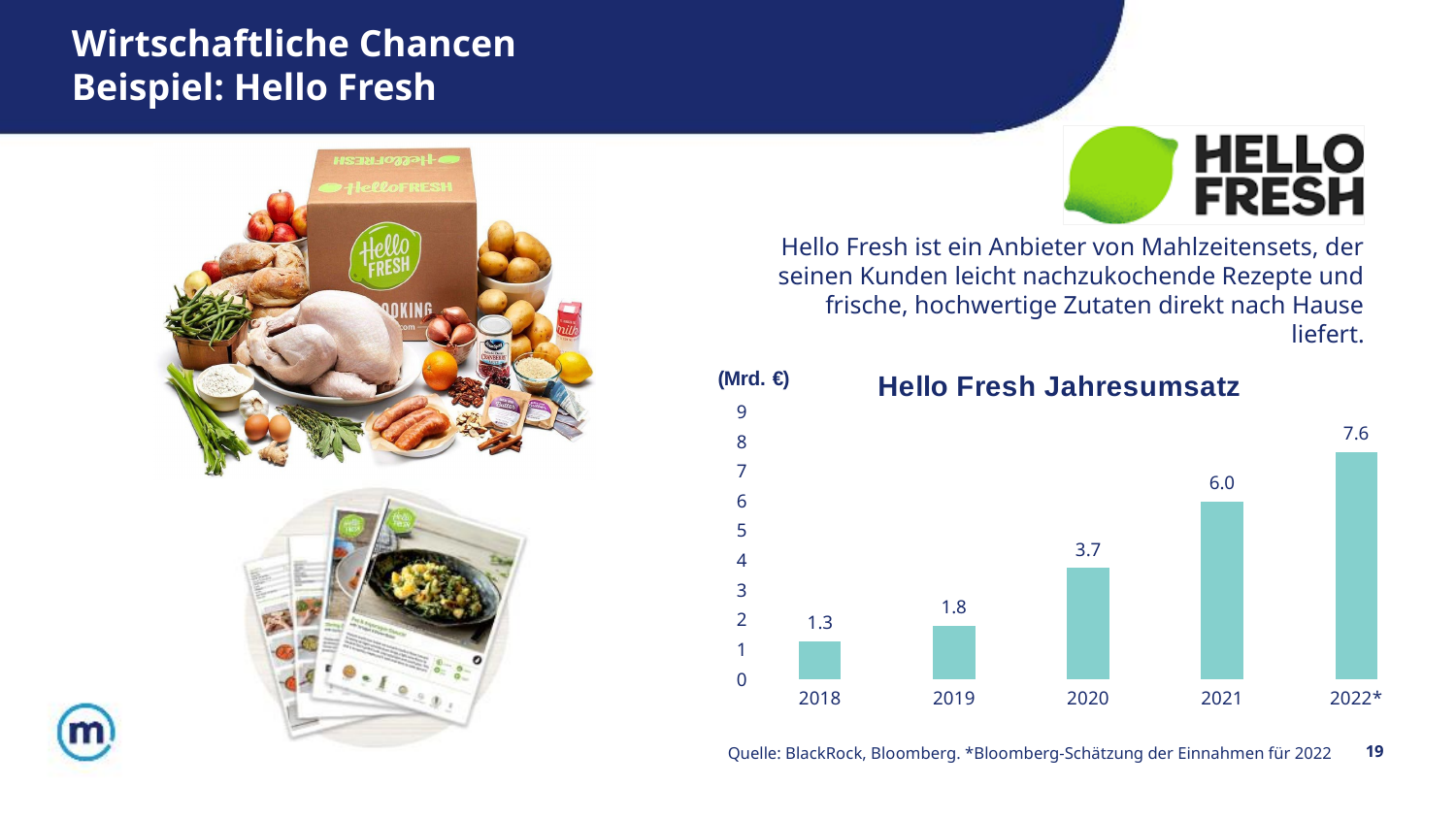
How many years are shown on the x axis of the Hello Fresh Jahresumsatz chart? 5 What kind of chart is the Hello Fresh Jahresumsatz chart? bar chart What unit is shown at the top of the y axis of the Hello Fresh Jahresumsatz chart? (Mrd. €) What is the difference between the values for 2021 and 2020 in the Hello Fresh Jahresumsatz chart? 2.3 Is the value for 2021 in the Hello Fresh Jahresumsatz chart greater or less than 5? greater Which is larger in the Hello Fresh Jahresumsatz chart, the value for 2019 or the value for 2021? 2021 What is the value for 2022* in the Hello Fresh Jahresumsatz chart? 7.6 What is the value for 2020 in the Hello Fresh Jahresumsatz chart? 3.7 What is the value for 2018 in the Hello Fresh Jahresumsatz chart? 1.3 Do the values in the Hello Fresh Jahresumsatz chart rise or fall from 2018 to 2022*? rise Which year has the lowest value in the Hello Fresh Jahresumsatz chart? 2018 Which year has the highest value in the Hello Fresh Jahresumsatz chart? 2022*